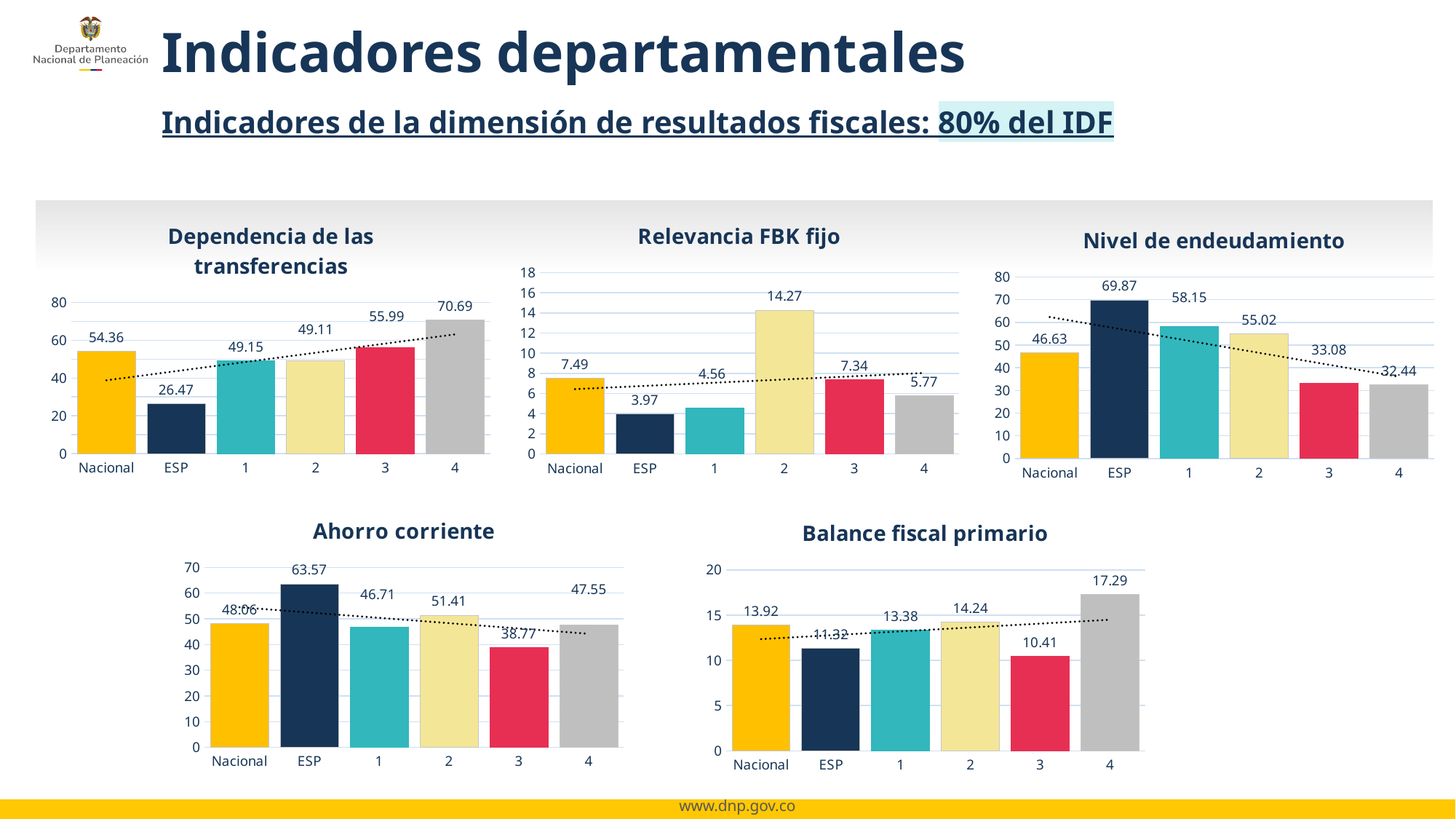
In the 'Ahorro corriente' chart, which is larger, the value for category 2 or the value for category 3? 2 In the 'Nivel de endeudamiento' chart, is the value for category 1 greater or less than 50? greater In the 'Nivel de endeudamiento' chart, what is the difference between the values for ESP and Nacional? 23.24 In the 'Relevancia FBK fijo' chart, what is the value for ESP? 3.97 In the 'Balance fiscal primario' chart, which category has the highest value? 4 In the 'Ahorro corriente' chart, what is the value for Nacional? 48.06 In the 'Dependencia de las transferencias' chart, what is the value for category 4? 70.69 In the 'Balance fiscal primario' chart, what is the value for category 3? 10.41 How many categories are shown on the x axis of the 'Balance fiscal primario' chart? 6 What kind of chart is 'Nivel de endeudamiento'? bar chart In the 'Relevancia FBK fijo' chart, which category has the highest value? 2 In the 'Dependencia de las transferencias' chart, which category has the lowest value? ESP